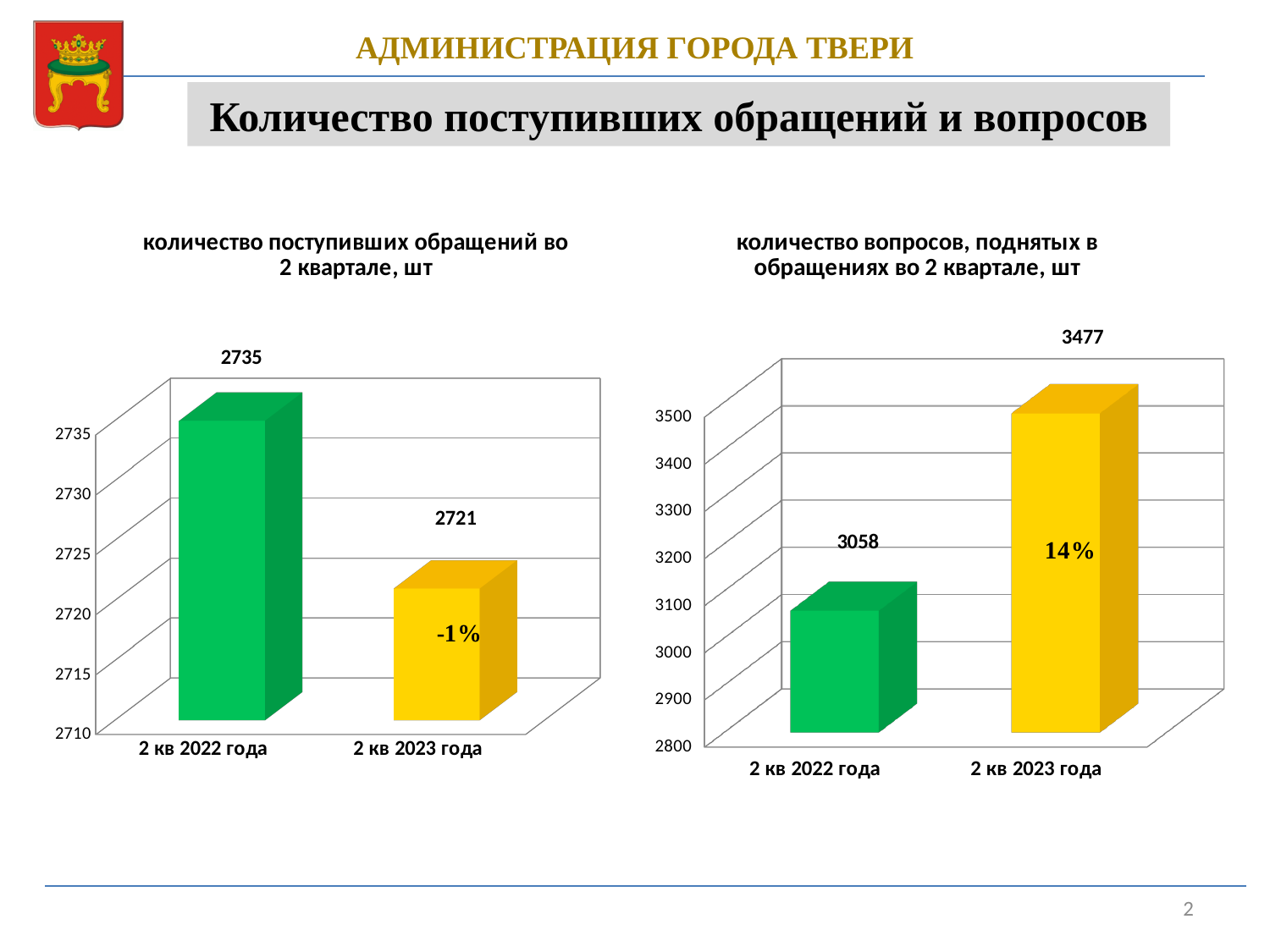
In the left chart, which period has the higher value? 2 кв 2022 года In the right chart, which period has the lower value? 2 кв 2022 года In the left chart (количество поступивших обращений во 2 квартале, шт), what is the value for 2 кв 2022 года? 2735 In the right chart, do the values rise or fall from 2 кв 2022 года to 2 кв 2023 года? Rise What percentage change is printed on the 2 кв 2023 года bar in the left chart? -1% In the right chart (количество вопросов, поднятых в обращениях во 2 квартале, шт), what is the value for 2 кв 2023 года? 3477 In the right chart, what is the difference between the values for 2 кв 2023 года and 2 кв 2022 года? 419 What kind of chart is the left chart? Bar chart In the left chart (количество поступивших обращений во 2 квартале, шт), what is the value for 2 кв 2023 года? 2721 In the left chart, what is the difference between the values for 2 кв 2022 года and 2 кв 2023 года? 14 In the right chart (количество вопросов, поднятых в обращениях во 2 квартале, шт), what is the value for 2 кв 2022 года? 3058 In the right chart, is the value for 2 кв 2022 года greater or less than 3000? greater